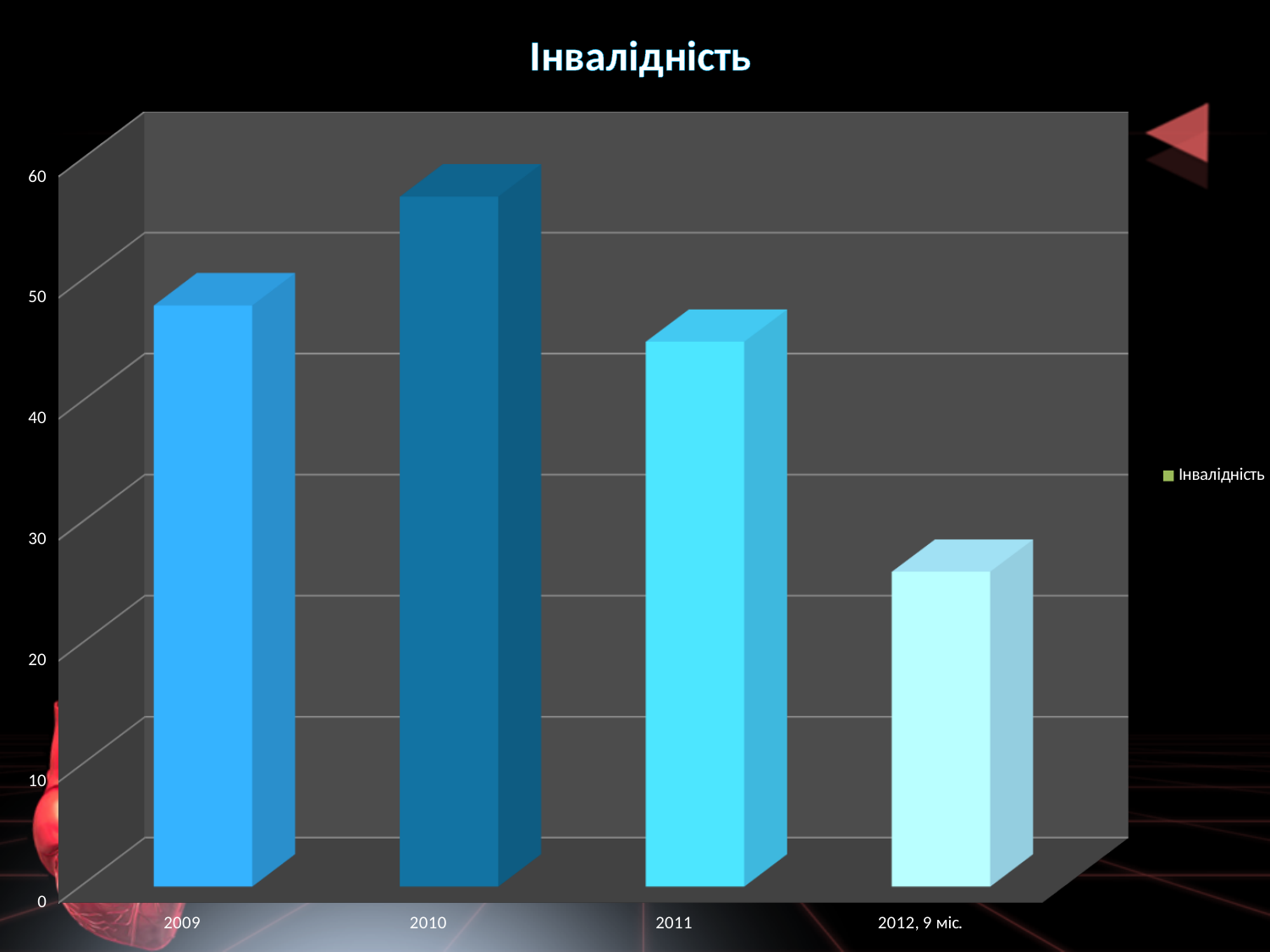
From 2010 to 2012, 9 міс., do the values rise or fall? fall Which category has the highest value in the chart? 2010 What kind of chart is shown on the slide? bar chart Is the value for 2010 greater or less than 50? greater Which category has the lowest value in the chart? 2012, 9 міс. How many categories are shown on the x axis of the chart? 4 Is the value for 2009 greater or less than 40? greater Is the value for 2012, 9 міс. greater or less than 30? less What is the title of the chart? Інвалідність How many series does the legend of the chart list? 1 Which is larger, the value for 2009 or the value for 2010? 2010